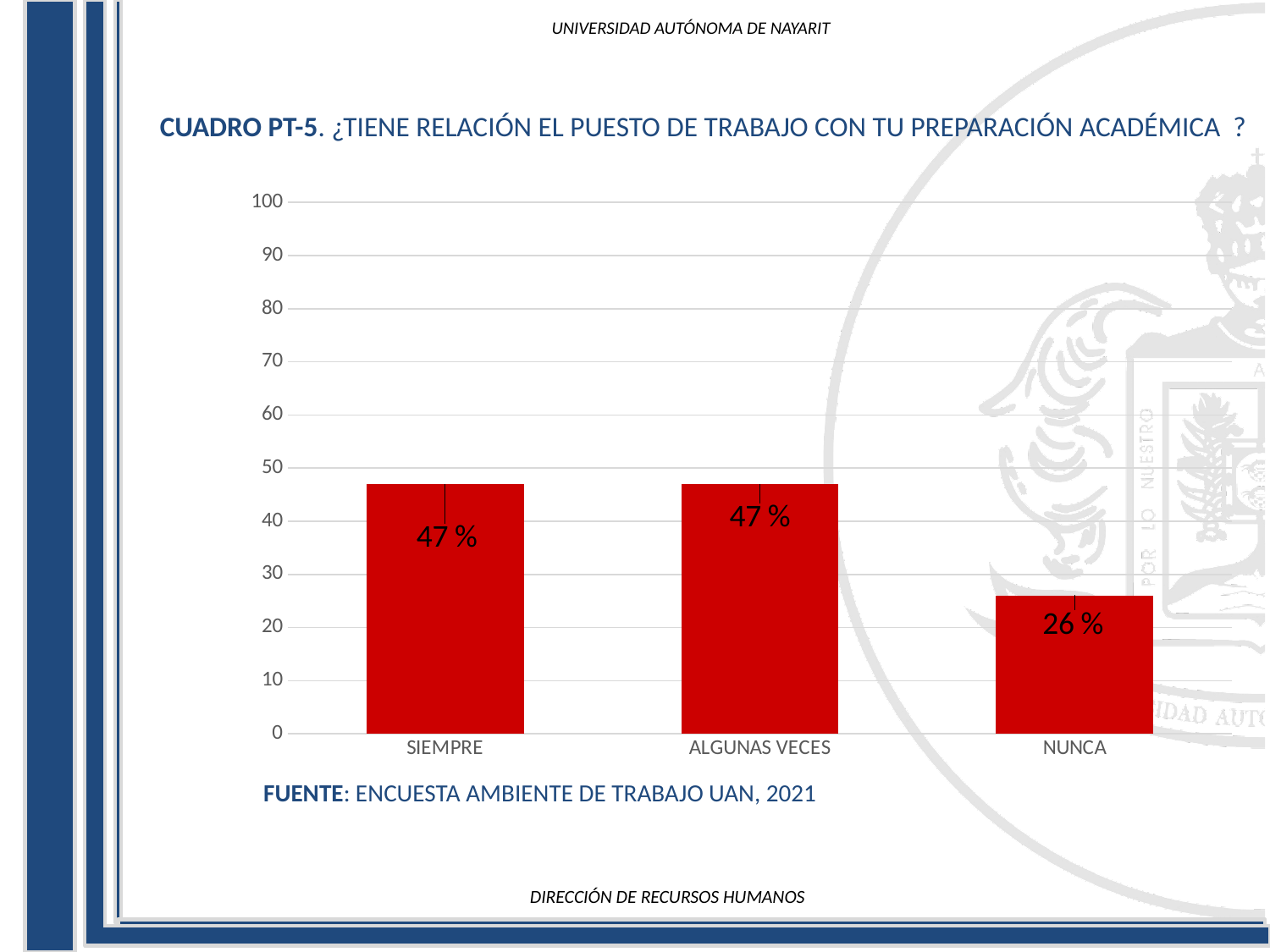
What is the value for SIEMPRE? 47 % What is the value for NUNCA? 26 % Is the value for NUNCA greater or less than 30? less Is the value for SIEMPRE greater or less than 40? greater What colour are the bars in the chart? red What is the difference between the values for SIEMPRE and NUNCA? 21 % What is the value for ALGUNAS VECES? 47 % What kind of chart is shown on the slide? bar chart Which category has the lowest value? NUNCA Which is larger, the value for ALGUNAS VECES or the value for NUNCA? ALGUNAS VECES What source is cited below the chart? ENCUESTA AMBIENTE DE TRABAJO UAN, 2021 How many categories are shown on the x axis? 3